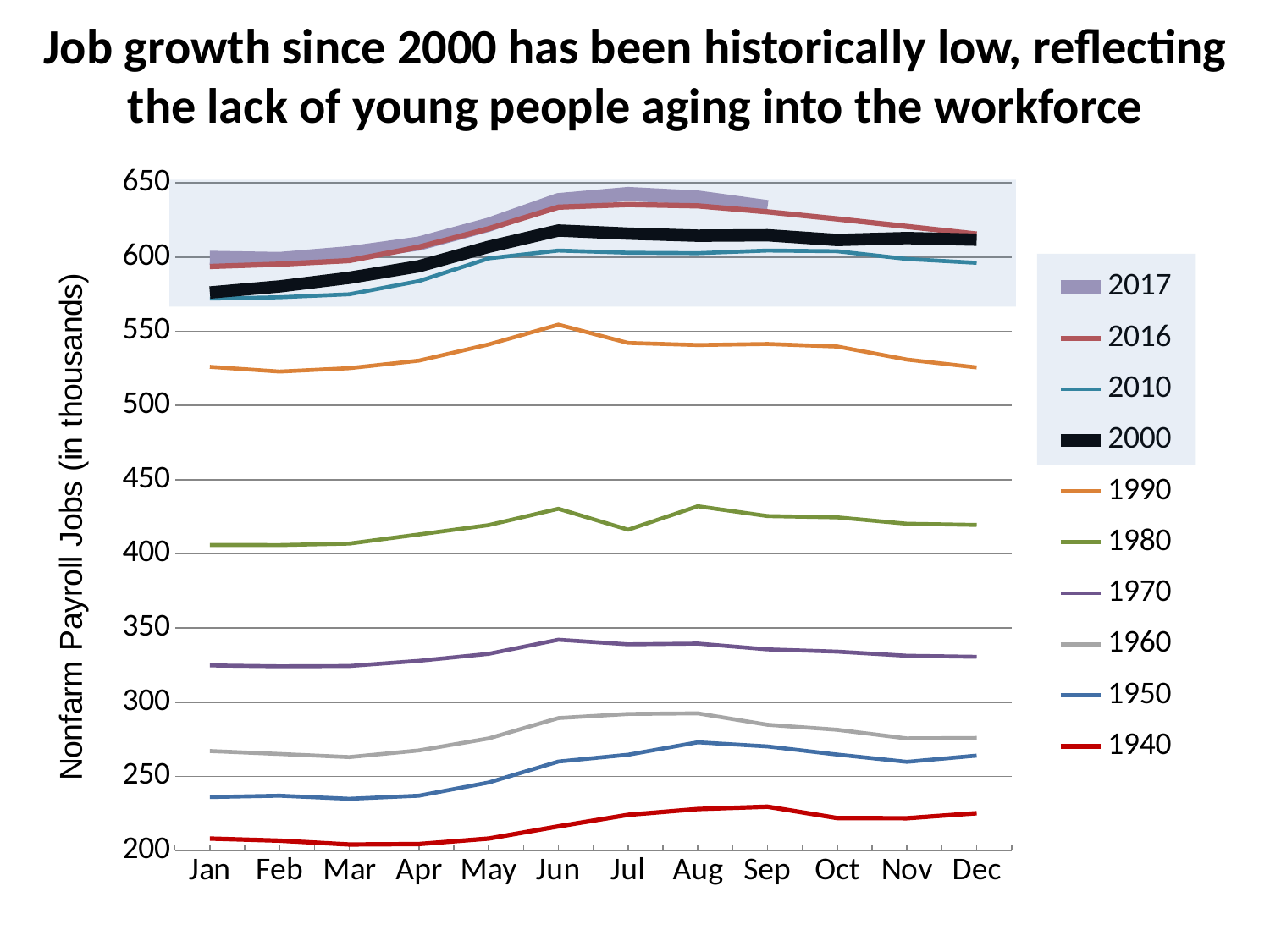
Is the value for 1980 in Jan greater or less than 450? less Is the value for 2000 in Jun greater or less than 600? greater Does the 1990 line rise or fall from Jun to Dec? fall Is the value for 1990 in Jun greater or less than 500? greater Which series has the lowest value in Jan? 1940 How many months are shown along the x axis? 12 What kind of chart is shown on the slide? line chart In Jul, which series has the higher value, 1970 or 1960? 1970 What is the title of the y axis? Nonfarm Payroll Jobs (in thousands) How many series does the legend list? 10 Which series has the highest value in Jul? 2017